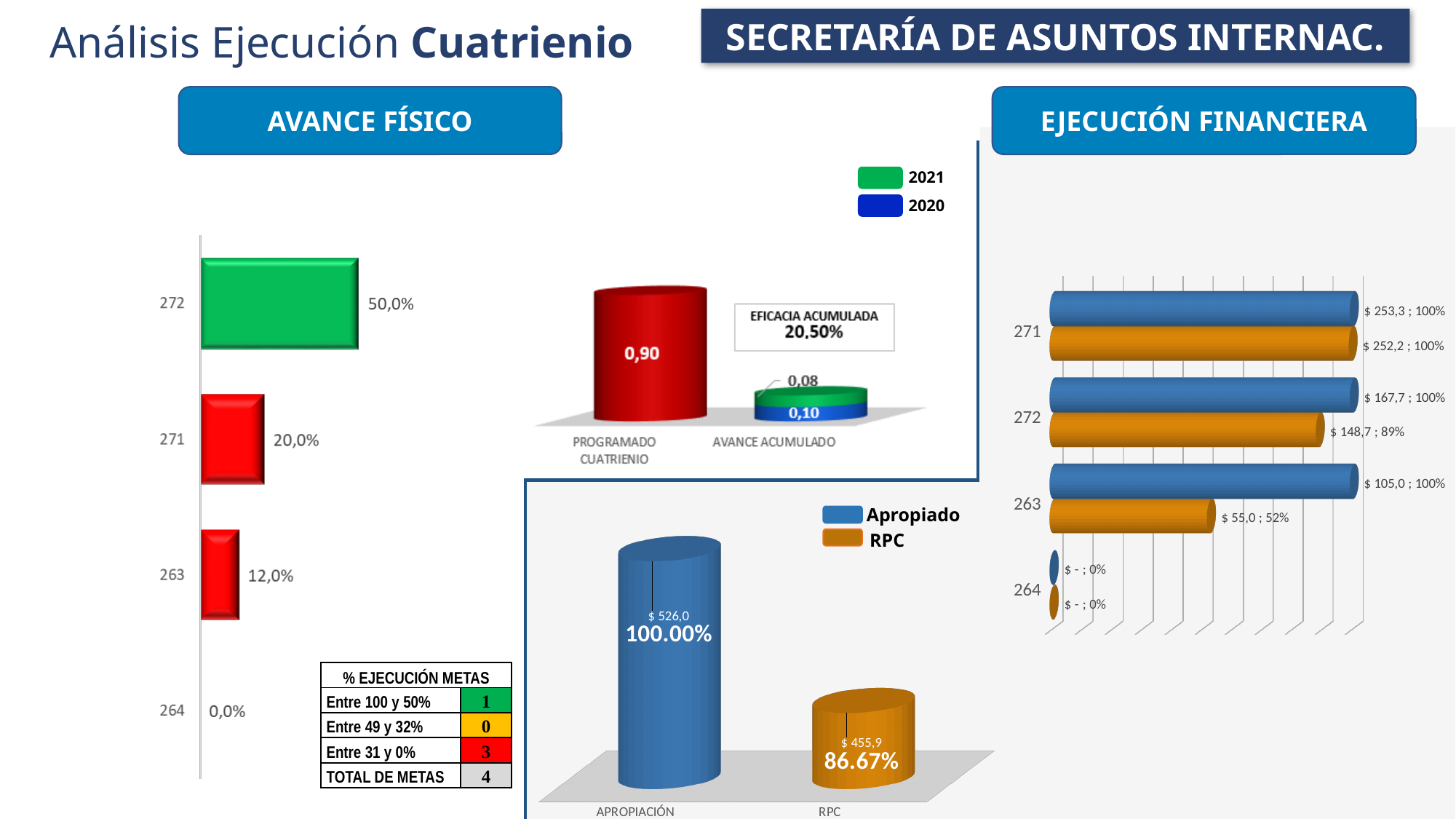
In the AVANCE FÍSICO bar chart on the left, what is the value for category 272? 50,0% In the chart with PROGRAMADO CUATRIENIO and AVANCE ACUMULADO, what is the 2021 value for AVANCE ACUMULADO? 0,08 In the chart with PROGRAMADO CUATRIENIO and AVANCE ACUMULADO, what is the total of the stacked AVANCE ACUMULADO bar? 0,18 In the EJECUCIÓN FINANCIERA bar chart on the right, what is the RPC value for category 263? $ 55,0 ; 52% In the AVANCE FÍSICO bar chart on the left, which category has the highest value? 272 In the bottom-middle chart with APROPIACIÓN and RPC, what is the value for RPC? $ 455,9 How many categories are shown in the AVANCE FÍSICO bar chart on the left? 4 In the bottom-middle chart with APROPIACIÓN and RPC, what percentage is shown for RPC? 86.67% In the EJECUCIÓN FINANCIERA bar chart on the right, how many series does the legend list? 2 In the AVANCE FÍSICO bar chart on the left, which category has the lowest value? 264 In the AVANCE FÍSICO bar chart on the left, what is the difference between the values for 271 and 263? 8,0% In the chart with PROGRAMADO CUATRIENIO and AVANCE ACUMULADO, what is the value for PROGRAMADO CUATRIENIO? 0,90